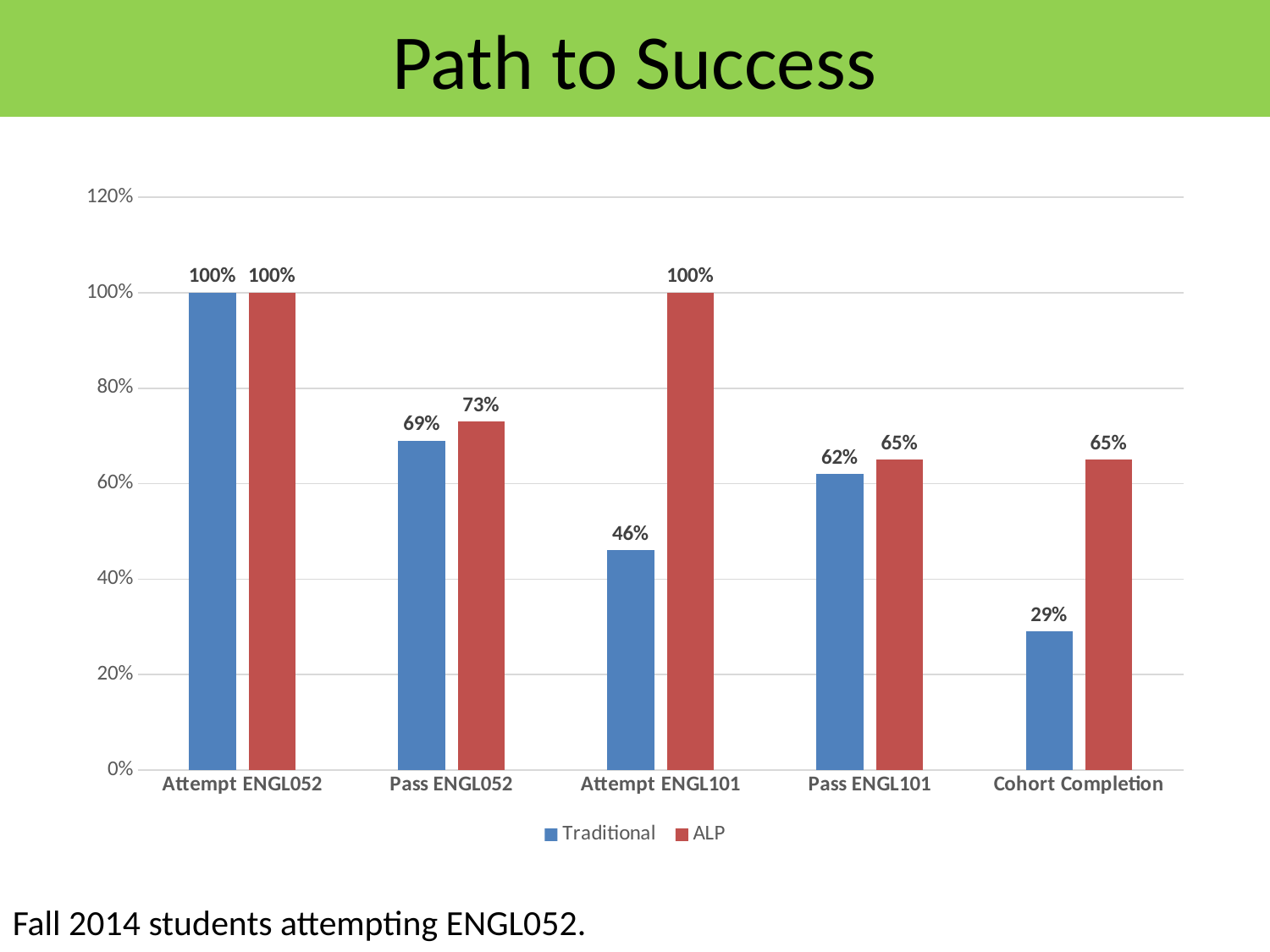
How many categories are shown on the x axis? 5 Which category has the lowest Traditional value? Cohort Completion What is the Traditional value for Attempt ENGL101? 46% What is the Traditional value for Pass ENGL052? 69% Which category has the lowest ALP value? Pass ENGL101 and Cohort Completion (both 65%) What is the difference between the ALP and Traditional values for Cohort Completion? 36% What kind of chart is shown on the slide? Bar chart What is the ALP value for Cohort Completion? 65% Which is larger for Pass ENGL052, the Traditional value or the ALP value? ALP How many series does the legend list? 2 Which series is shown in red? ALP What is the difference between the ALP and Traditional values for Attempt ENGL101? 54%